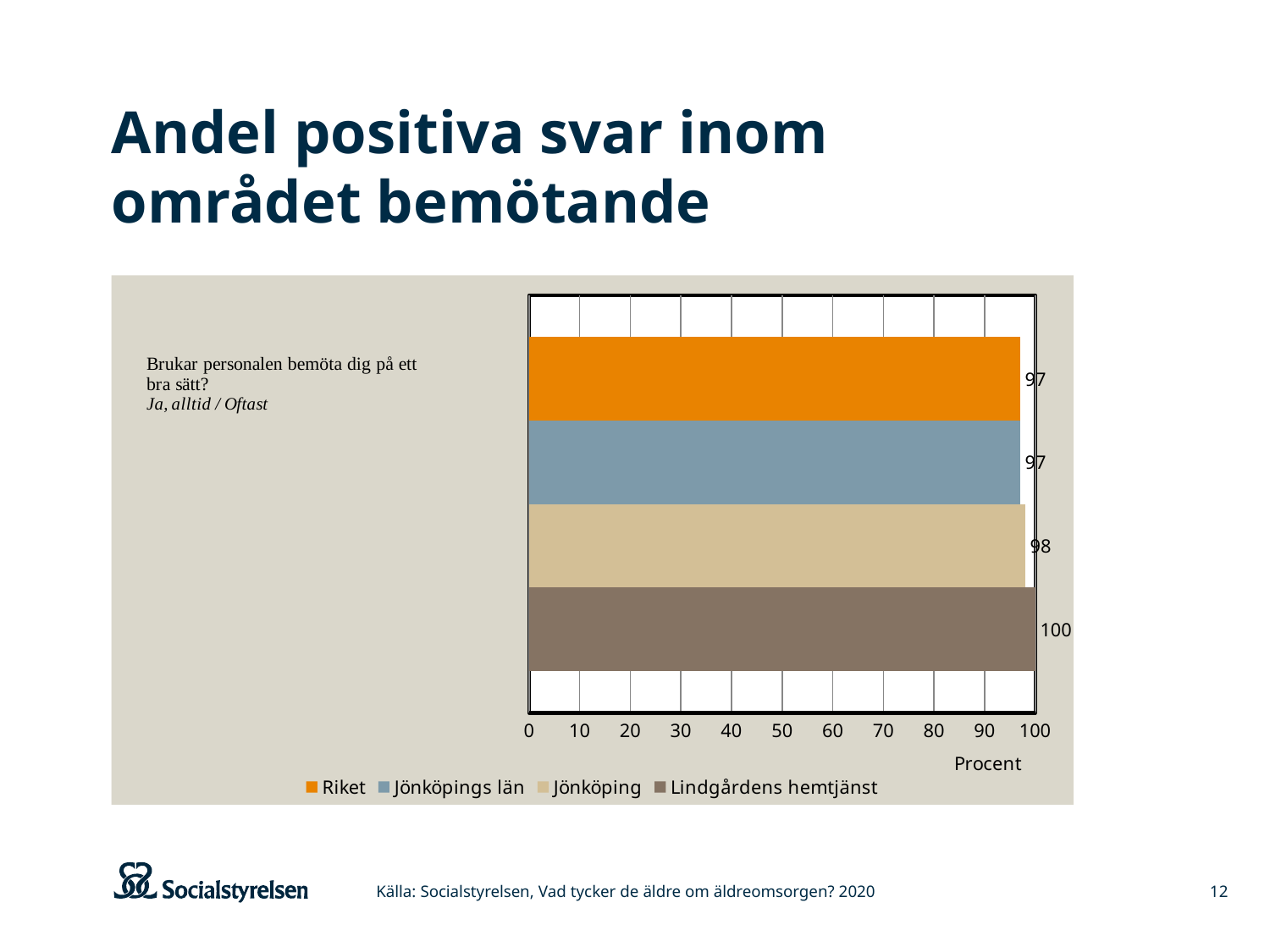
Which series has the highest value? Lindgårdens hemtjänst Is the value for Riket greater or less than 90? greater Which is larger, the value for Lindgårdens hemtjänst or the value for Jönköping? Lindgårdens hemtjänst What is the difference between the values for Lindgårdens hemtjänst and Riket? 3 What is the value for Lindgårdens hemtjänst? 100 How many series does the legend list? 4 What is the difference between the values for Jönköping and Jönköpings län? 1 What is the label on the horizontal axis of the chart? Procent What is the value for Jönköping? 98 What kind of chart is shown on the slide? bar chart What is the value for Riket? 97 What is the value for Jönköpings län? 97